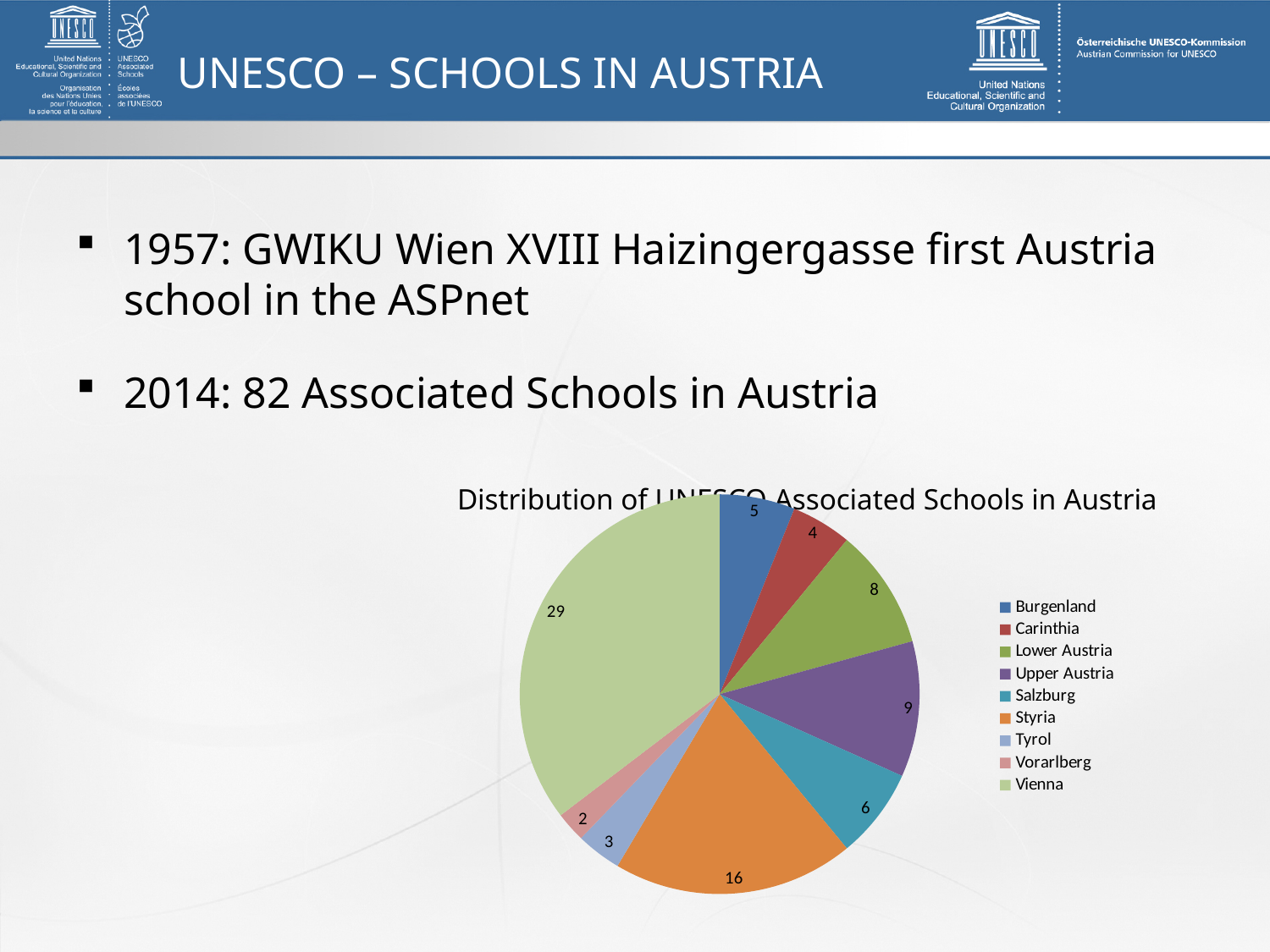
What is the difference between the values for Vienna and Styria? 13 What is the title of the pie chart? Distribution of UNESCO Associated Schools in Austria What is the difference between the values for Lower Austria and Carinthia? 4 Which region has the smallest slice in the pie chart? Vorarlberg What is the value for Upper Austria in the pie chart? 9 What kind of chart is shown on the slide? pie chart Which is larger, the value for Salzburg or the value for Tyrol? Salzburg Which region has the largest slice in the pie chart? Vienna How many regions does the legend of the pie chart list? 9 What is the value for Styria in the pie chart? 16 How many schools does the pie chart show for Vienna? 29 What is the value for Vorarlberg in the pie chart? 2